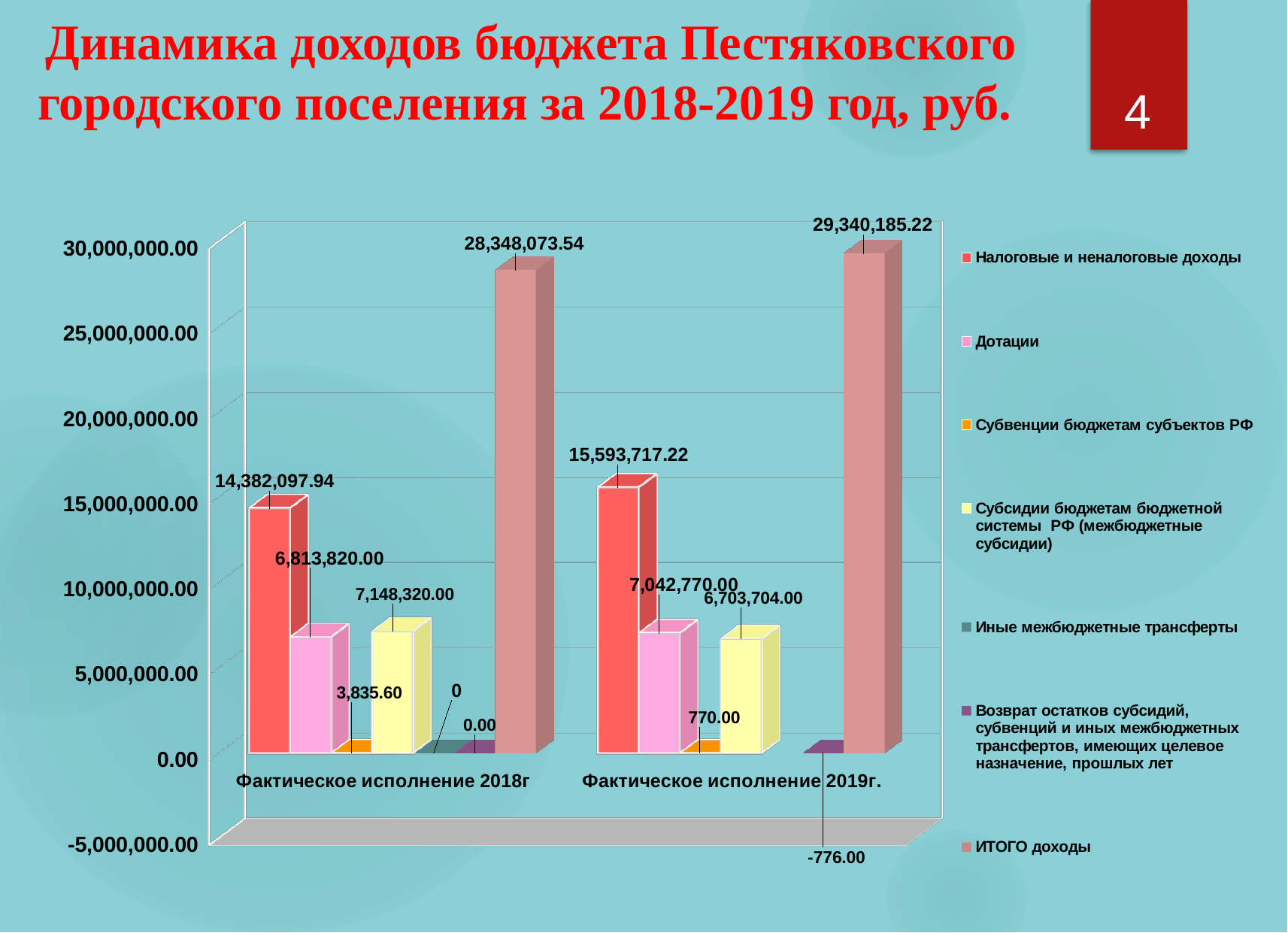
What is the value of Субвенции бюджетам субъектов РФ for Фактическое исполнение 2019г.? 770.00 In Фактическое исполнение 2018г, which is larger: Дотации or Субсидии бюджетам бюджетной системы РФ? Субсидии бюджетам бюджетной системы РФ How many series does the legend list? 7 Which series has the lowest value for Фактическое исполнение 2019г.? Возврат остатков субсидий, субвенций и иных межбюджетных трансфертов, имеющих целевое назначение, прошлых лет What is the value of ИТОГО доходы for Фактическое исполнение 2019г.? 29,340,185.22 Does ИТОГО доходы rise or fall from 2018 to 2019? rise How many categories are shown on the x axis? 2 What is the difference between Налоговые и неналоговые доходы in 2019 and in 2018? 1,211,619.28 By how much did ИТОГО доходы increase from 2018 to 2019? 992,111.68 What is the value of Возврат остатков субсидий, субвенций и иных межбюджетных трансфертов for Фактическое исполнение 2019г.? -776.00 What is the value of Субсидии бюджетам бюджетной системы РФ for Фактическое исполнение 2018г? 7,148,320.00 What is the value of Налоговые и неналоговые доходы for Фактическое исполнение 2018г? 14,382,097.94